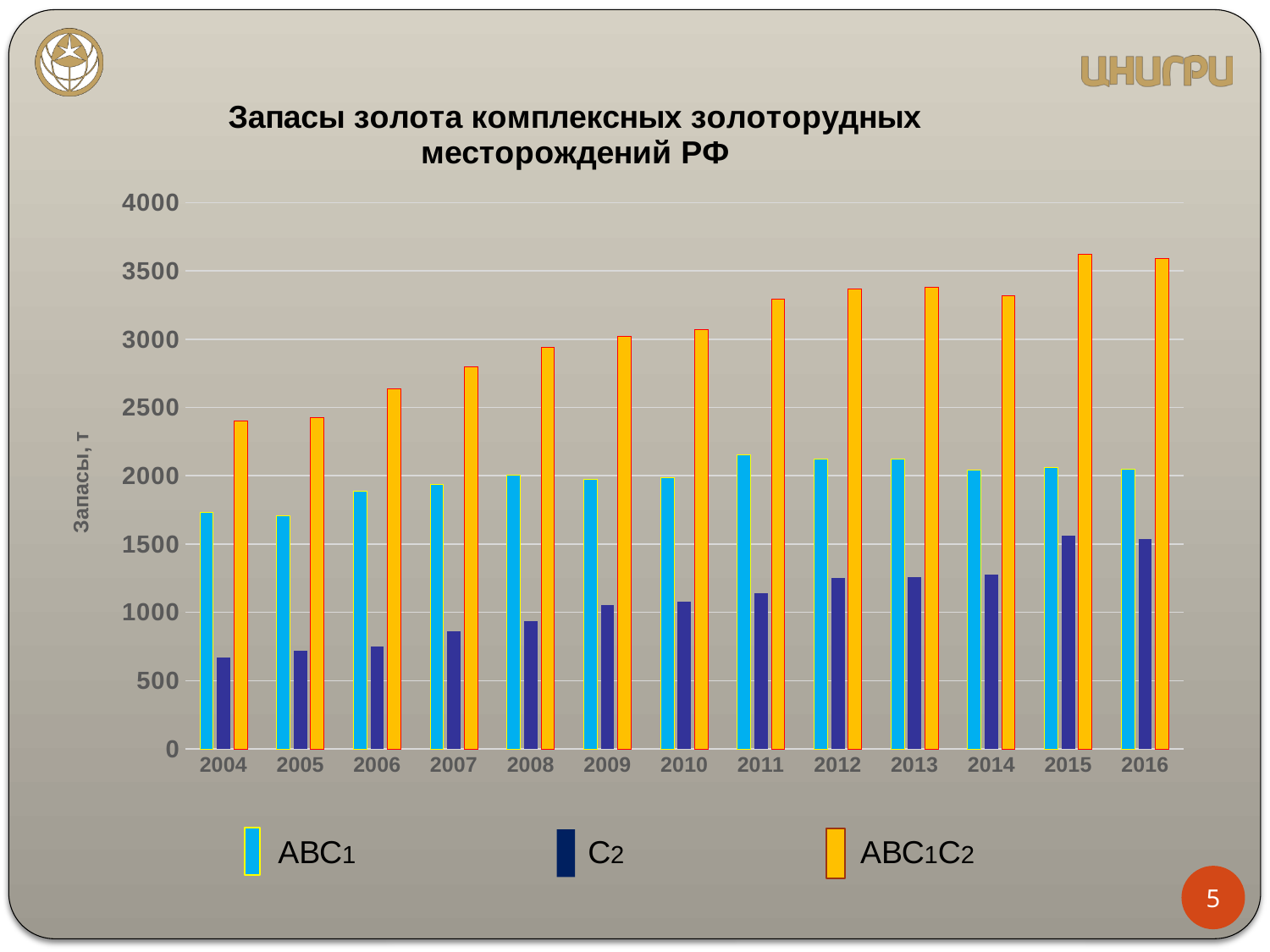
Is the value for C2 in 2015 greater or less than 1500? greater Is the value for ABC1C2 in 2016 greater or less than 3500? greater Is the value for ABC1C2 in 2004 greater or less than 2500? less Does the C2 series generally rise or fall from 2004 to 2016? rise What kind of chart is shown on the slide? bar chart How many series does the legend list? 3 Which is larger in 2004, the ABC1 bar or the C2 bar? ABC1 What is the label on the vertical axis? Запасы, т How many years are shown on the x axis? 13